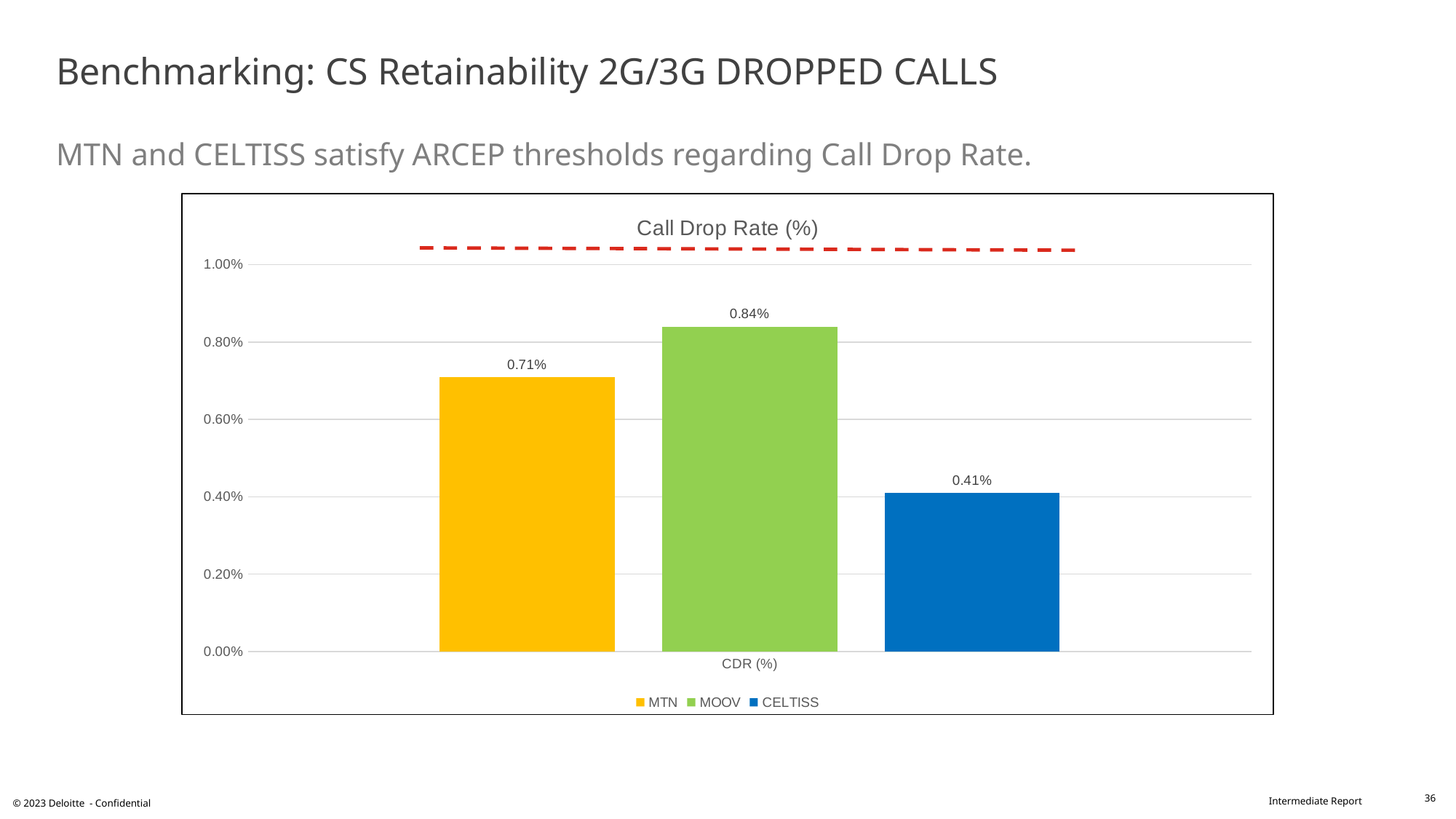
Which operator has the lowest Call Drop Rate? CELTISS Is the Call Drop Rate for MOOV greater or less than 1.00%? less What is the difference between the Call Drop Rate of MTN and CELTISS? 0.30% What is the Call Drop Rate for MTN? 0.71% What kind of chart is shown on the slide? Bar chart What is the Call Drop Rate for MOOV? 0.84% How many series does the legend list? 3 Which has a higher Call Drop Rate, MTN or CELTISS? MTN What is the Call Drop Rate for CELTISS? 0.41% Which operator has the highest Call Drop Rate? MOOV What is the title of the chart? Call Drop Rate (%) What is the difference between the Call Drop Rate of MOOV and MTN? 0.13%